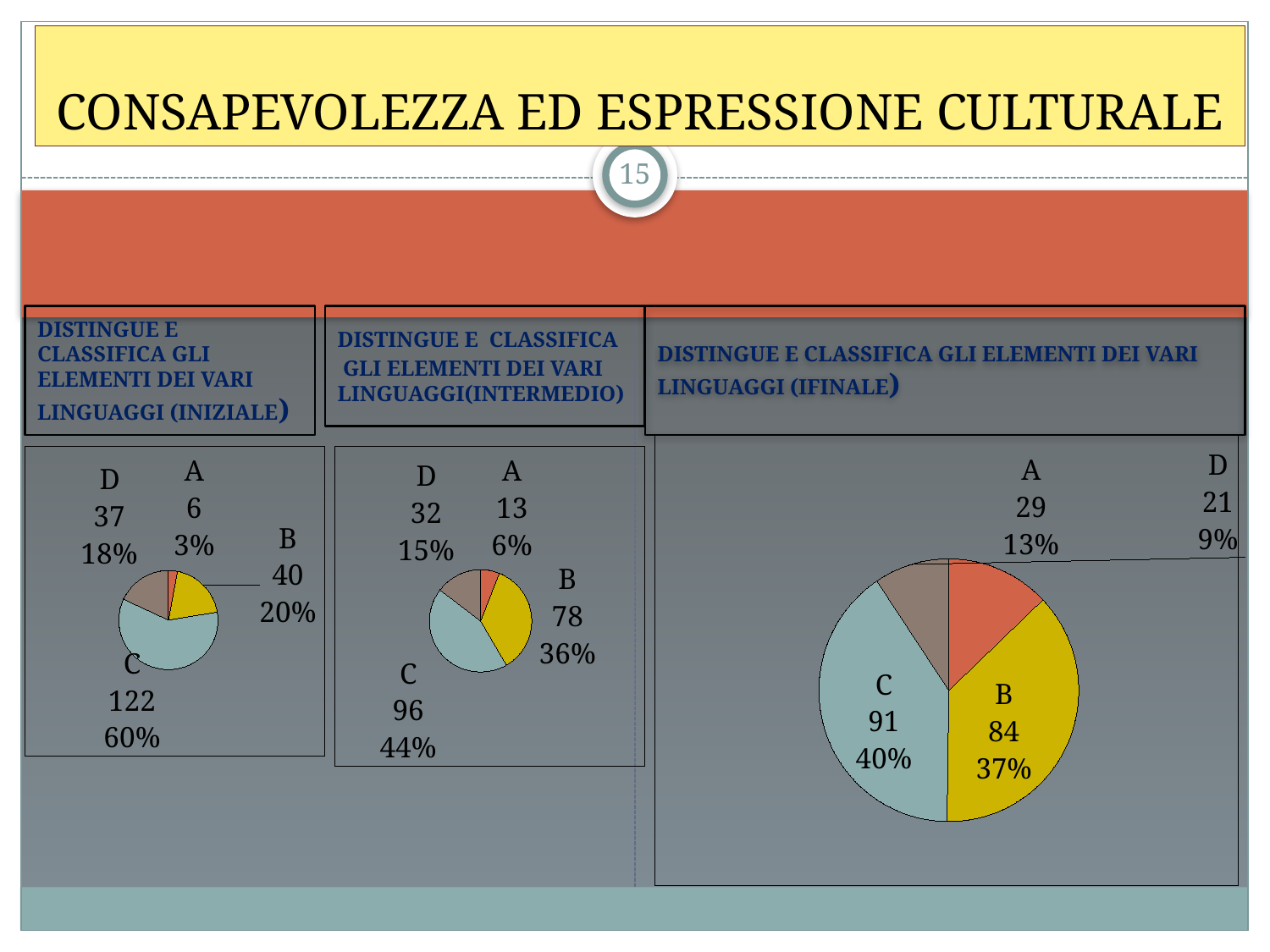
In the left pie chart (INIZIALE), which category has the smallest value? A In the middle pie chart (INTERMEDIO), what value is shown for category B? 78 In the middle pie chart (INTERMEDIO), what is the difference between the values for C and B? 18 In the right pie chart (FINALE), what value is shown for category D? 21 How many categories does the right pie chart (FINALE) show? 4 In the right pie chart (FINALE), which is larger, the value for A or the value for D? A What kind of chart is used in the left panel (INIZIALE)? Pie chart How many pie charts are shown on the slide? 3 In the right pie chart (FINALE), what percentage share does category C have? 40% In the middle pie chart (INTERMEDIO), which category has the largest value? C In the left pie chart (INIZIALE), what percentage share does category B have? 20% In the left pie chart (INIZIALE), what value is shown for category C? 122